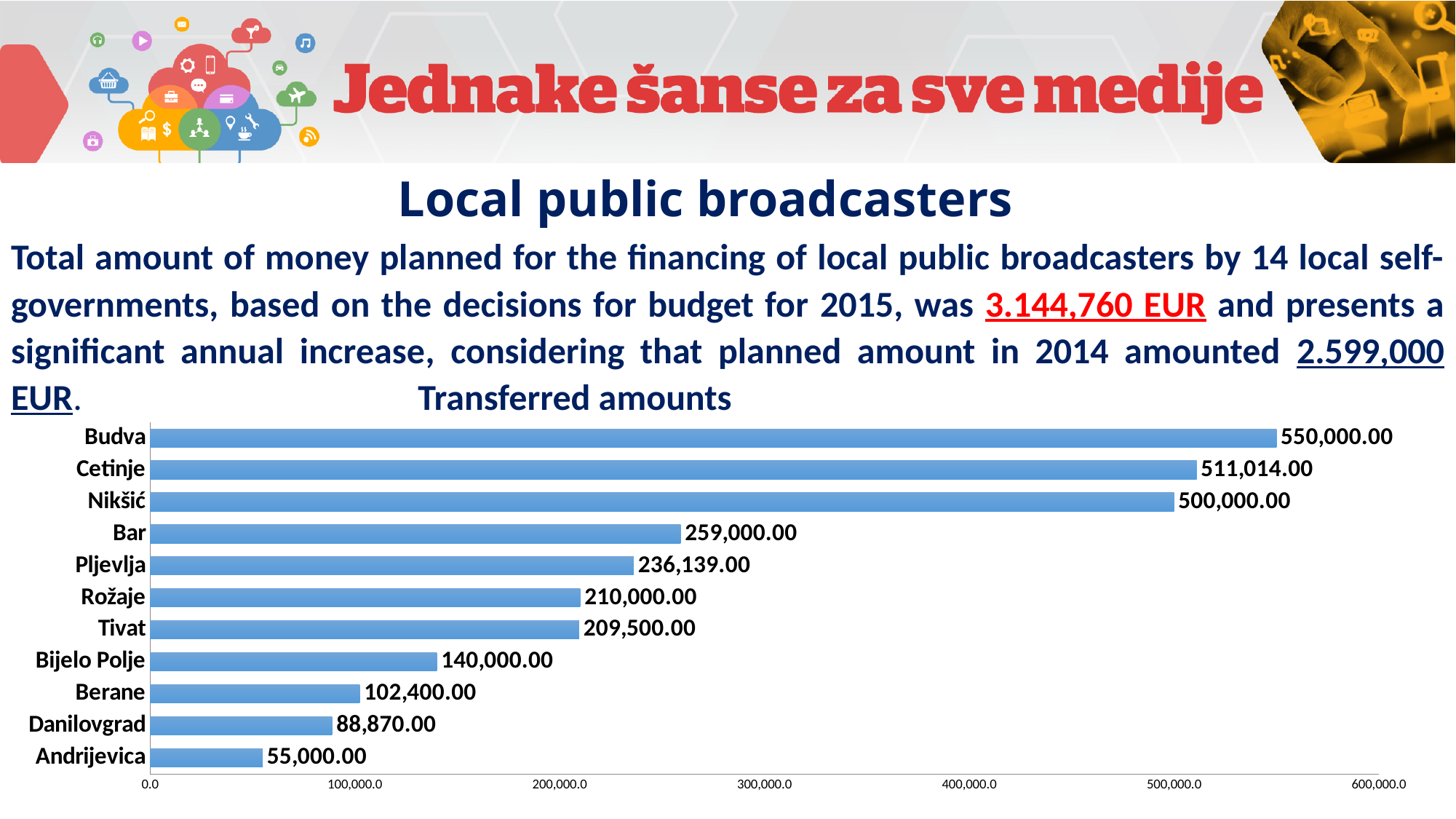
What is the title of the chart? Transferred amounts What is the transferred amount for Pljevlja? 236,139.00 What is the transferred amount for Danilovgrad? 88,870.00 Which category has the lowest transferred amount? Andrijevica What kind of chart is shown on the slide? Bar chart What is the difference between the transferred amounts for Bar and Bijelo Polje? 119,000.00 Which category has the highest transferred amount? Budva What is the transferred amount for Budva? 550,000.00 What is the difference between the transferred amounts for Cetinje and Nikšić? 11,014.00 How many categories are shown in the chart? 11 Is the transferred amount for Tivat greater or less than 200,000.0? greater Which has a larger transferred amount, Rožaje or Berane? Rožaje